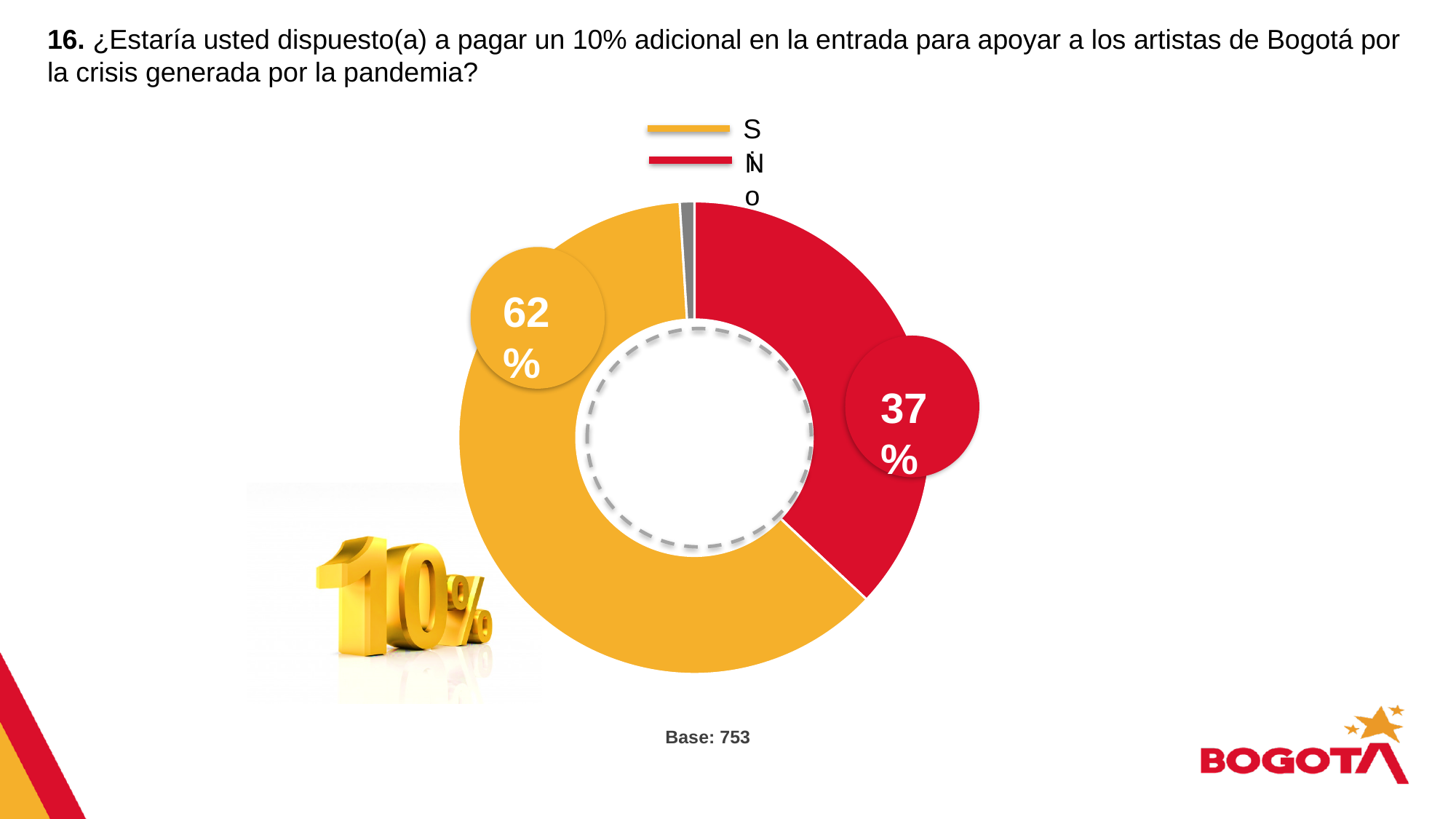
Is the share for "Sí" greater or less than 50%? greater Which response has the largest share of the donut chart? Sí By how many percentage points does "Sí" exceed "No"? 25 percentage points What is the base (number of respondents) shown below the chart? 753 What percentage of respondents answered "Sí"? 62% What type of chart is shown on the slide? Donut (pie) chart Which colour represents the "No" response in the chart? Red What percentage of respondents answered "No"? 37% Which is larger, the share for "Sí" or the share for "No"? Sí How many entries does the legend list? 2 Of the two labeled responses, which has the smaller share? No